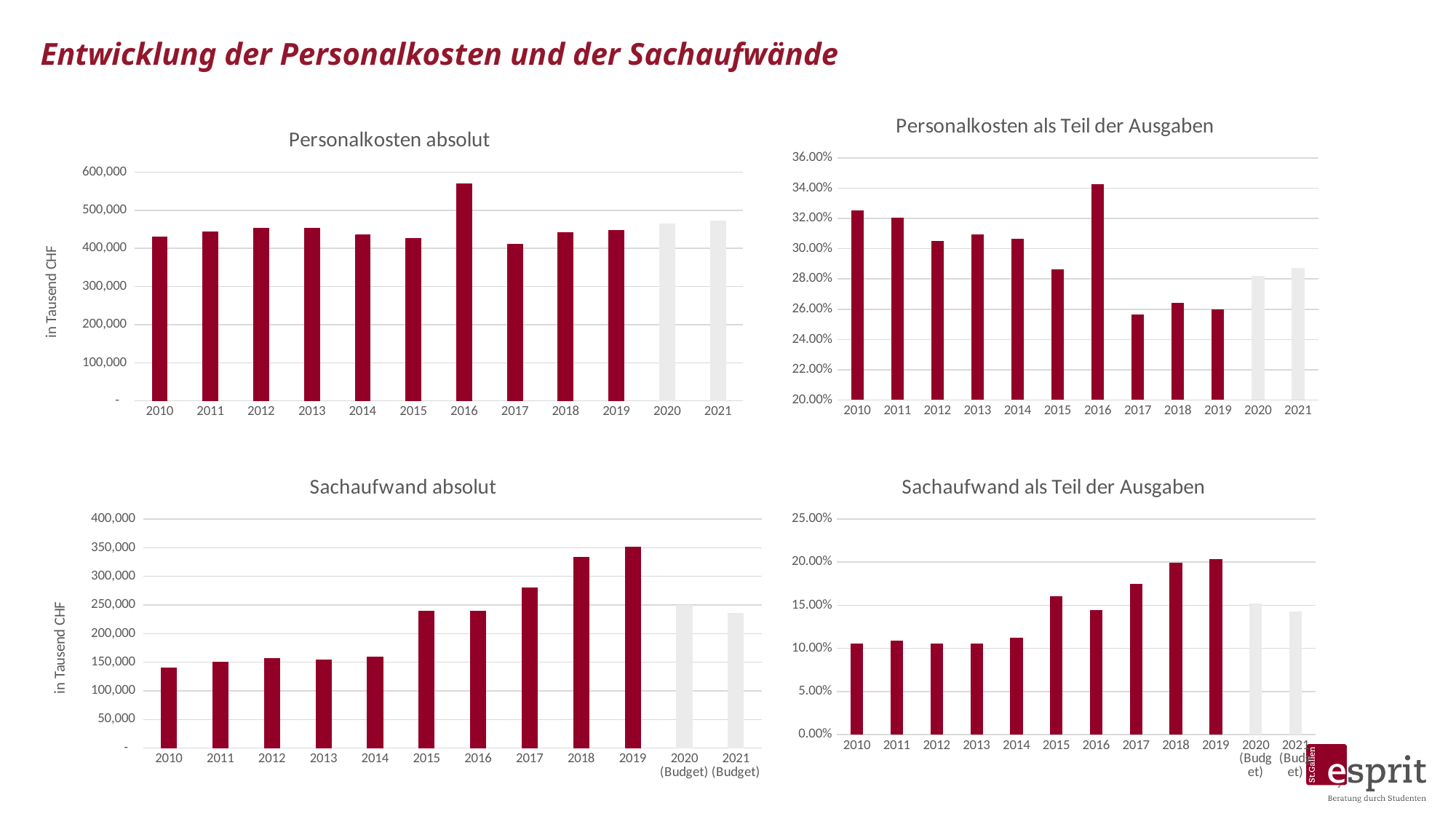
In the 'Sachaufwand absolut' chart, is the value for 2018 greater or less than 300,000? greater How many years (categories) are shown on the x axis of the 'Personalkosten absolut' chart? 12 What is the y-axis label of the 'Sachaufwand absolut' chart? in Tausend CHF What kind of chart is 'Personalkosten absolut'? bar chart In the 'Personalkosten als Teil der Ausgaben' chart, which year has the highest value? 2016 How many charts are shown on the slide? 4 In the 'Personalkosten absolut' chart, is the value for 2016 greater or less than 500,000? greater In the 'Personalkosten als Teil der Ausgaben' chart, which is larger, the value for 2015 or the value for 2016? 2016 In the 'Sachaufwand als Teil der Ausgaben' chart, do the values generally rise or fall from 2010 to 2019? rise In the 'Sachaufwand absolut' chart, which year has the lowest value? 2010 In the 'Personalkosten absolut' chart, which year has the highest value? 2016 In the 'Personalkosten als Teil der Ausgaben' chart, is the value for 2017 greater or less than 26.00%? less